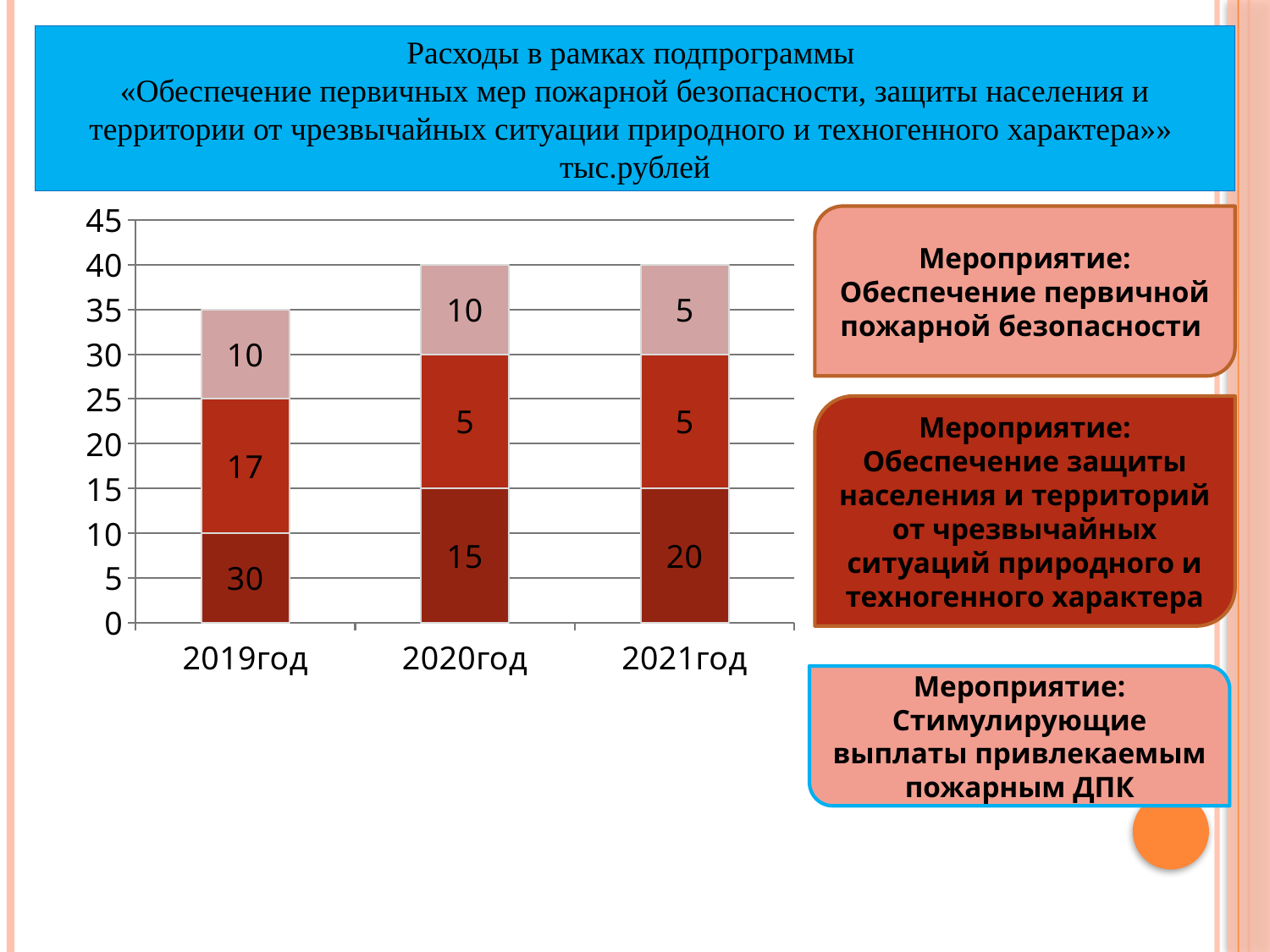
In what units are the values on the chart expressed, according to the slide title? тыс.рублей What is the data label on the middle segment of the 2019год bar? 17 What is the data label on the bottom (darkest) segment of the 2019год bar? 30 What is the data label on the bottom (darkest) segment of the 2021год bar? 20 What is the difference between the labelled bottom-segment values of 2019год (30) and 2021год (20)? 10 What is the data label on the top (light pink) segment of the 2020год bar? 10 What is the label of the first category on the x axis? 2019год What is the data label on the middle segment of the 2021год bar? 5 Which bar has the larger labelled value in its bottom (darkest) segment, 2019год or 2020год? 2019год What type of chart is shown on the slide? Stacked bar chart How many year categories are shown on the x axis of the chart? 3 What is the difference between the labelled top-segment values of 2020год (10) and 2021год (5)? 5